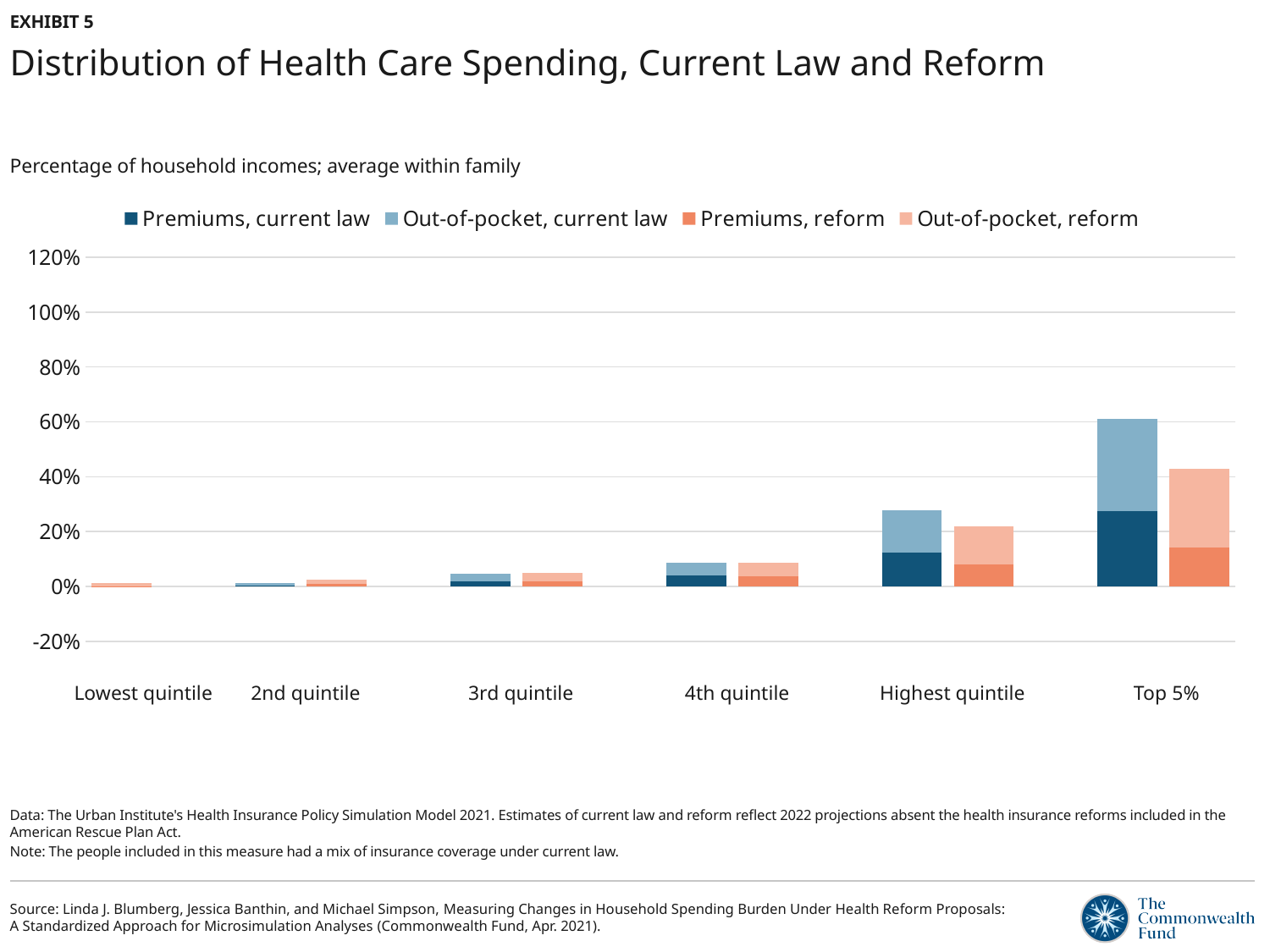
Do the stacked bar totals rise or fall moving from the Lowest quintile to the Top 5%? Rise Which income category has the shortest reform stacked bar? Lowest quintile What is the title of the chart? Distribution of Health Care Spending, Current Law and Reform Which income category has the tallest current-law stacked bar? Top 5% Is the total current-law spending for the Highest quintile greater or less than 20%? greater How many series does the legend list? 4 Is the total current-law spending for the 4th quintile greater or less than 20%? less Is the total current-law spending for the Top 5% greater or less than 40%? greater For the Top 5%, which stacked bar is taller: current law or reform? Current law How many income categories are shown along the x axis? 6 What kind of chart is shown on the slide? Stacked bar chart